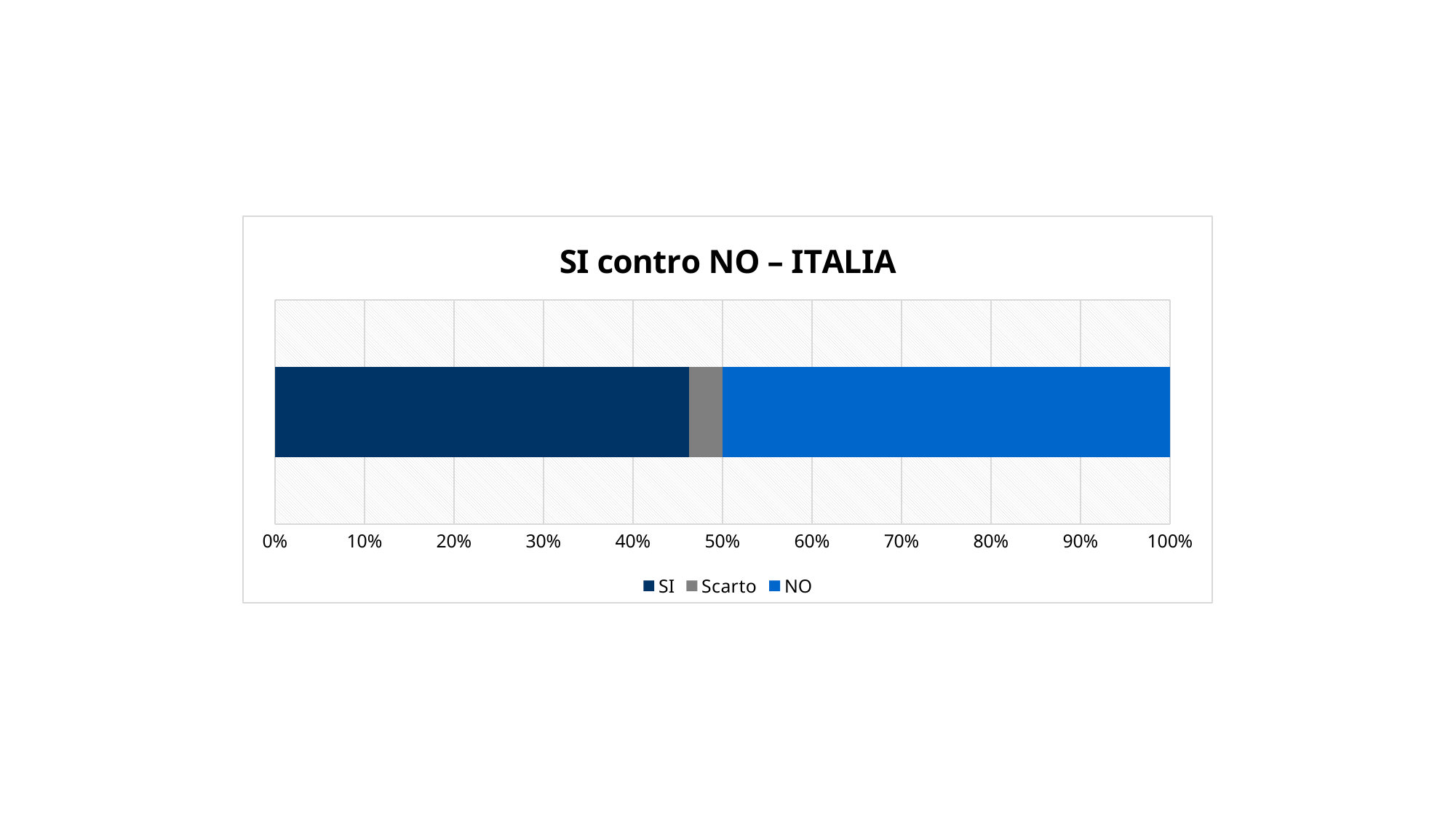
Which series is shown in grey in the legend? Scarto Which is larger, the SI segment or the Scarto segment? SI Is the value for NO greater or less than 40%? greater Which series has the smallest segment in the bar? Scarto What kind of chart is shown on the slide? stacked bar chart Is the value for Scarto greater or less than 10%? less What is the title of the chart? SI contro NO – ITALIA Is the value for SI greater or less than 40%? greater Which is larger, the NO segment or the Scarto segment? NO How many series does the legend list? 3 How many bars are plotted in the chart? 1